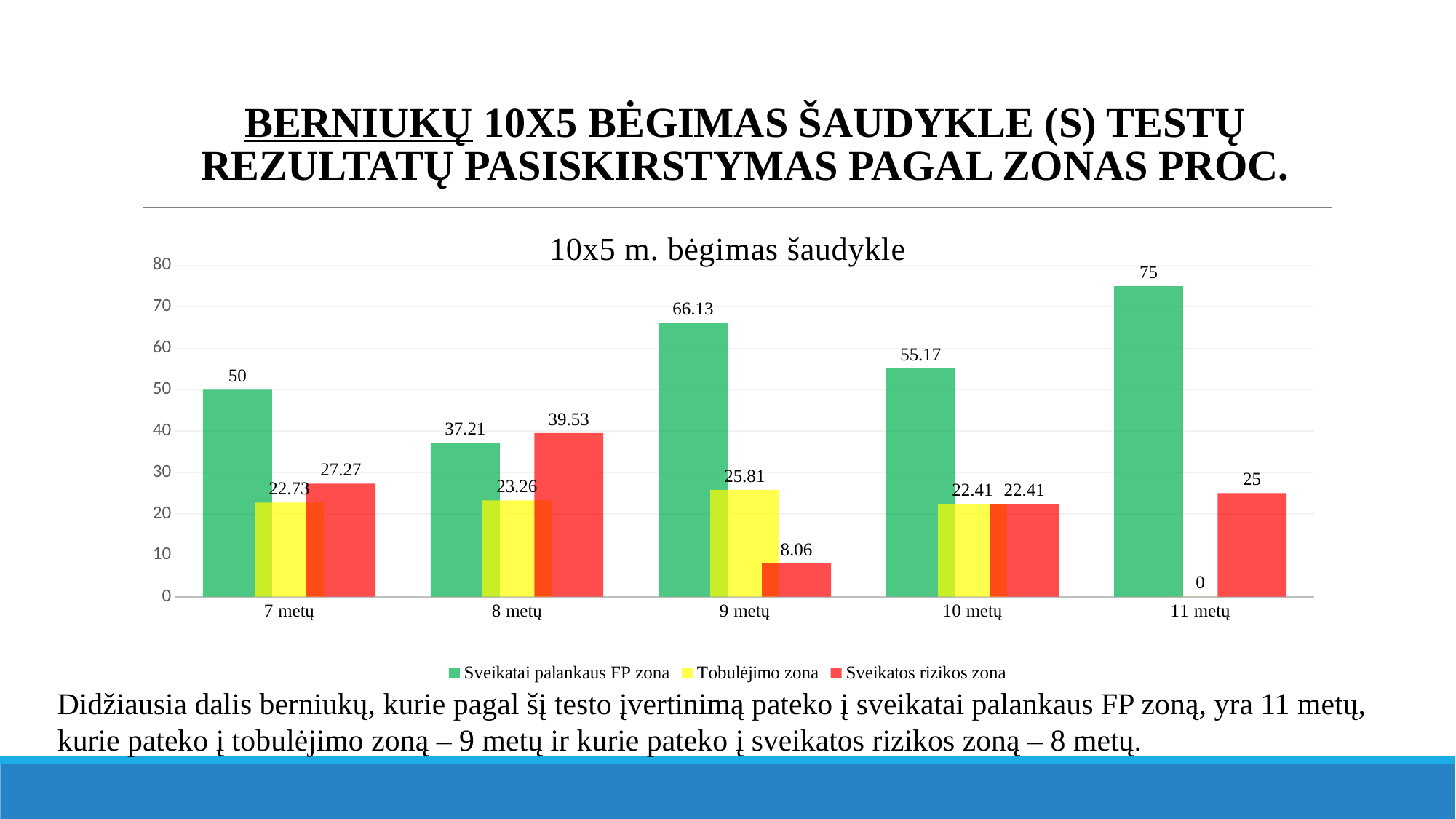
Which age group has the lowest value for Sveikatos rizikos zona? 9 metų Is the value of Sveikatai palankaus FP zona for 10 metų greater or less than 50? greater For 8 metų, which is larger: Sveikatai palankaus FP zona or Sveikatos rizikos zona? Sveikatos rizikos zona How many age groups are shown on the x axis? 5 What kind of chart is shown on the slide? Bar chart How many series does the legend list? 3 What is the value of Sveikatai palankaus FP zona for 9 metų? 66.13 Which age group has the highest value for Sveikatai palankaus FP zona? 11 metų What is the value of Sveikatos rizikos zona for 8 metų? 39.53 What is the difference between the Sveikatai palankaus FP zona values for 11 metų and 7 metų? 25 What is the value of Tobulėjimo zona for 11 metų? 0 What is the title of the chart? 10x5 m. bėgimas šaudykle